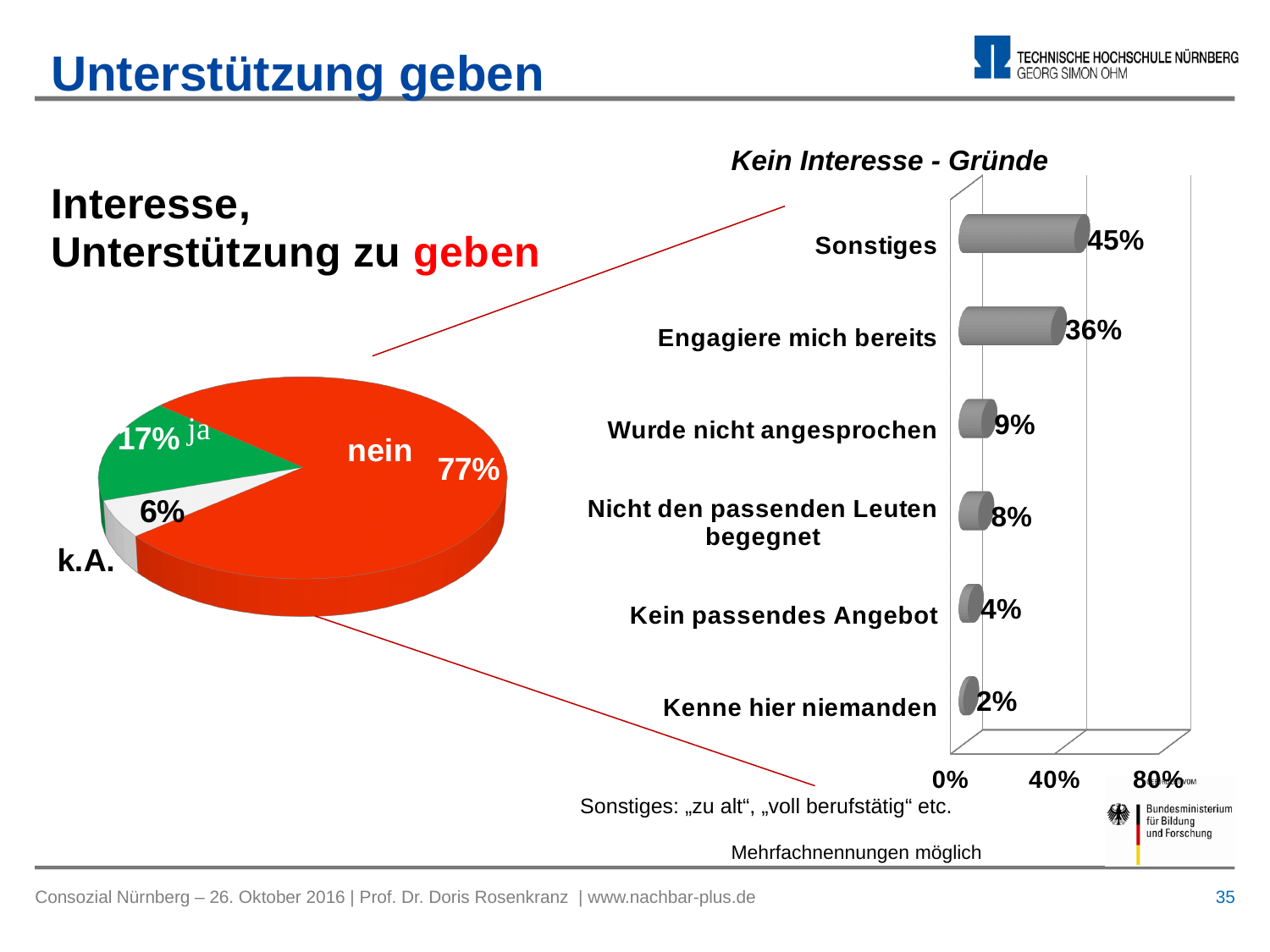
In the pie chart on the left, what share of respondents answered "ja"? 17% In the pie chart on the left, which slice is the largest? nein What kind of chart is the "Kein Interesse - Gründe" chart? Bar chart In the "Kein Interesse - Gründe" chart, what is the value for "Kenne hier niemanden"? 2% In the pie chart on the left, how many slices are there? 3 In the "Kein Interesse - Gründe" chart, how many categories are shown? 6 In the "Kein Interesse - Gründe" chart, what is the value for "Engagiere mich bereits"? 36% In the "Kein Interesse - Gründe" chart, which category has the lowest value? Kenne hier niemanden In the pie chart on the left, what share of respondents answered "nein"? 77% In the pie chart on the left, what share is labelled "k.A."? 6% In the "Kein Interesse - Gründe" chart, what is the difference between "Sonstiges" and "Engagiere mich bereits"? 9% In the "Kein Interesse - Gründe" chart, which category has the highest value? Sonstiges